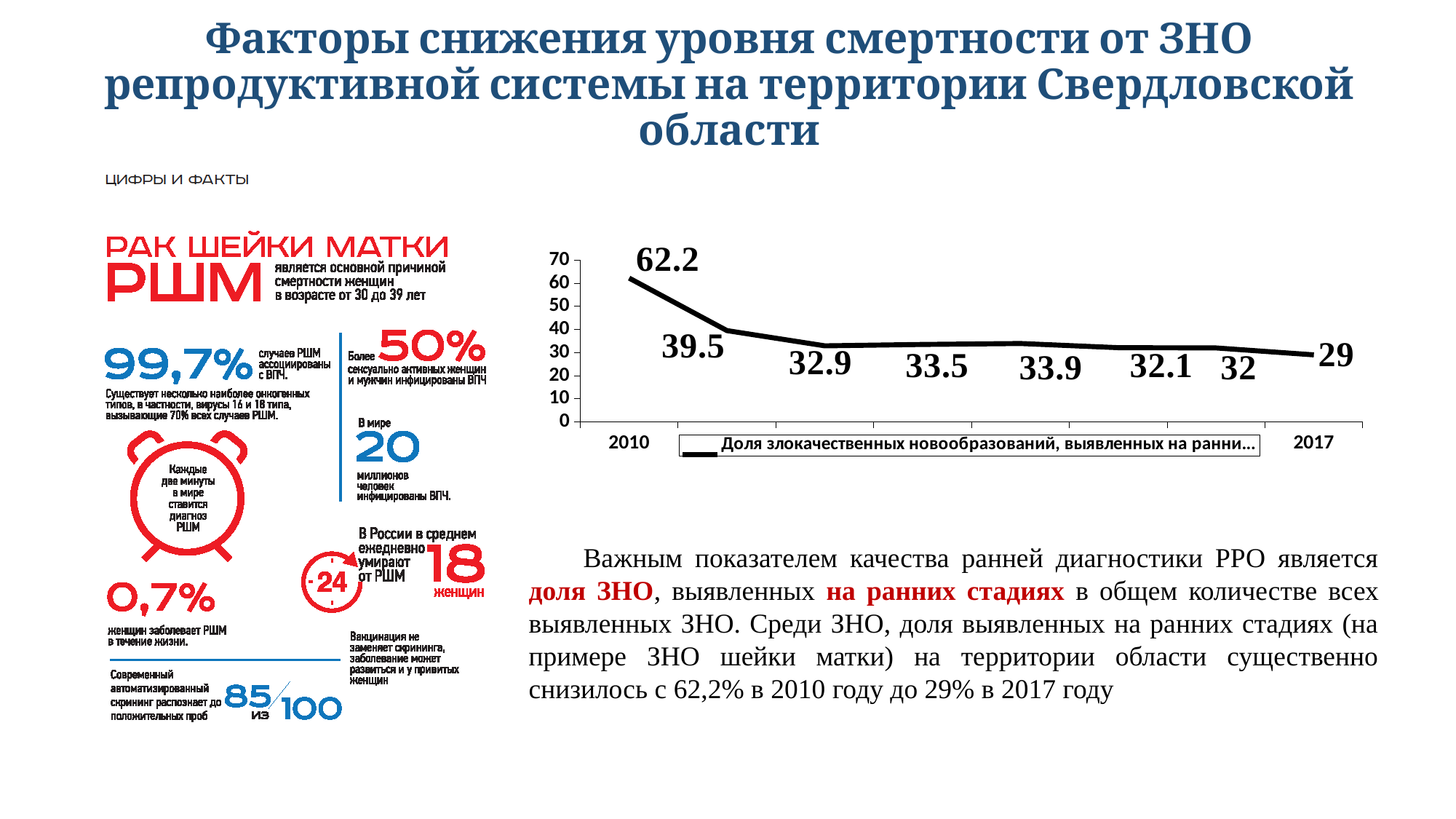
Which year has the highest value on the chart? 2010 Which year has the lowest value on the chart? 2017 Do the values generally rise or fall from 2010 to 2017? Fall How many series does the legend list? 1 By how much did the value fall from 2010 to 2017? 33.2 What colour is the plotted line? Black What kind of chart is shown on the slide? Line chart How many data points are plotted on the line? 8 What is the value plotted for 2017? 29 What is the value plotted for 2010? 62.2 What is the value of the second data point from the left on the line? 39.5 Which is larger, the value for 2010 or the value for 2017? 2010